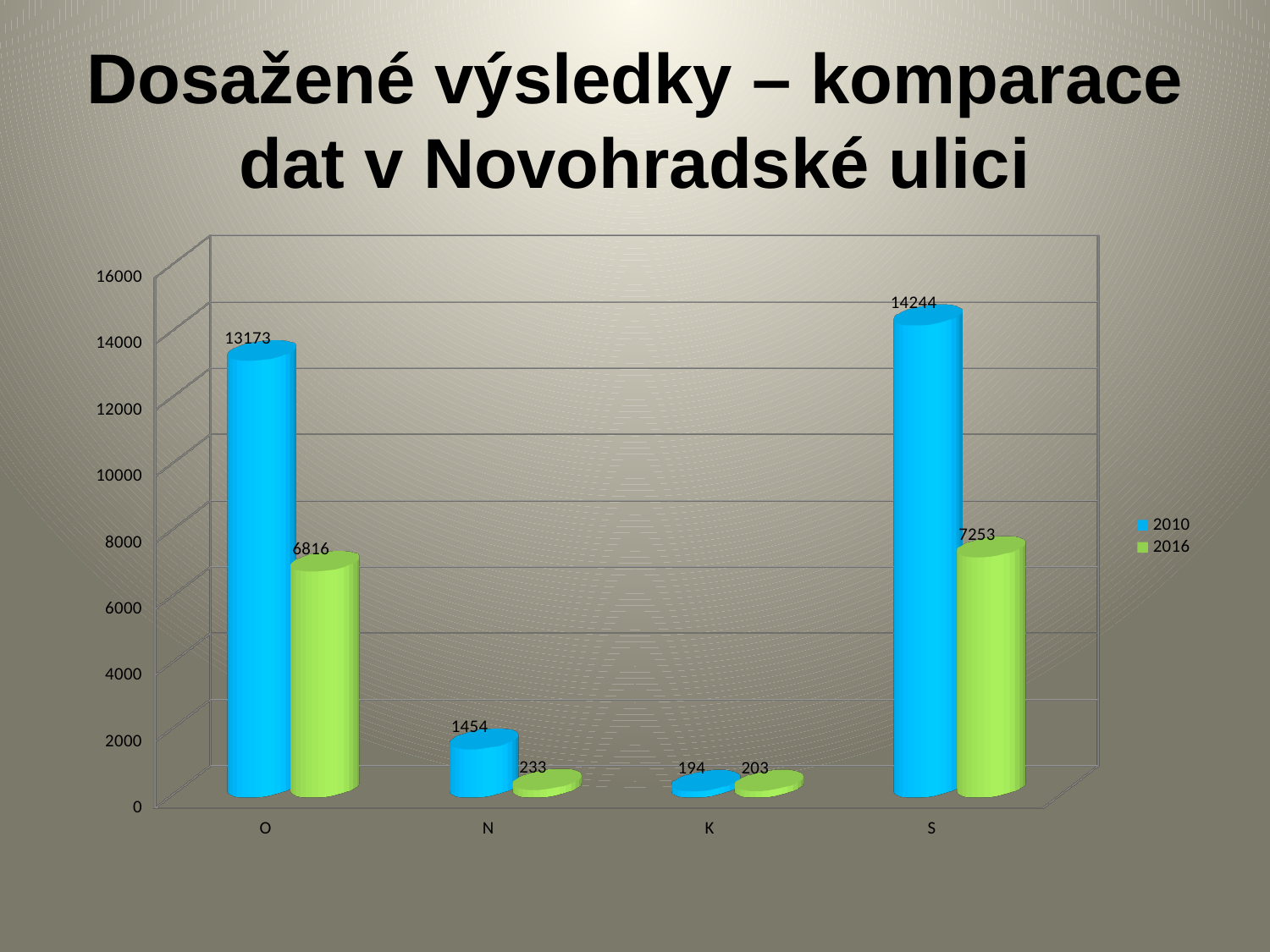
What is the value for category N in the 2016 series? 233 What kind of chart is shown on the slide? bar chart Which category has the lowest value in the 2016 series? K Which is larger for category K: the 2010 value or the 2016 value? 2016 How many categories are shown on the x axis? 4 What is the difference between the 2010 and 2016 values for category S? 6991 What is the difference between the 2010 and 2016 values for category O? 6357 What is the value for category O in the 2010 series? 13173 What is the value for category S in the 2016 series? 7253 Which category has the highest value in the 2010 series? S How many series does the legend list? 2 Which series is shown in green in the legend? 2016